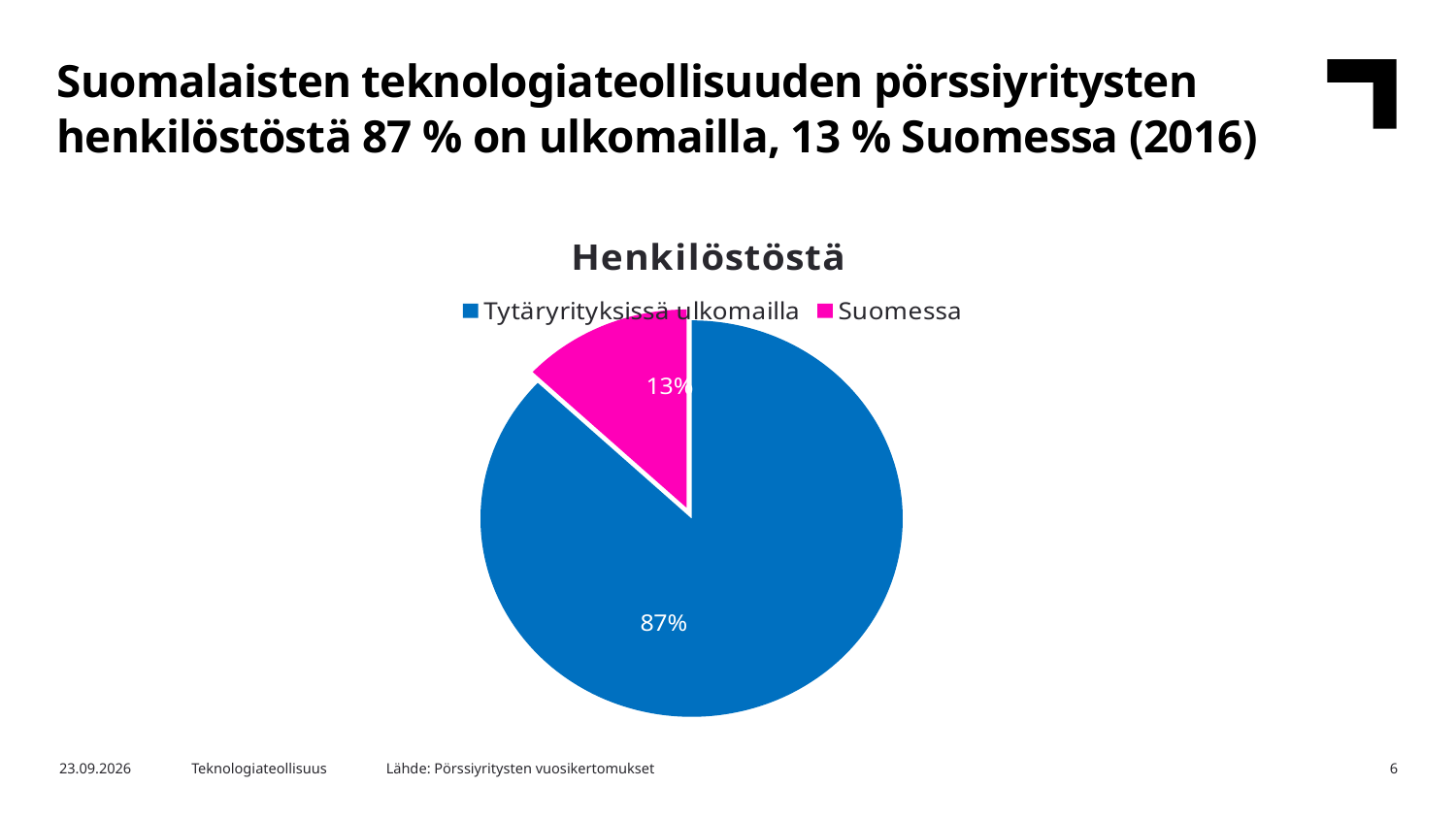
Which is larger, the 'Suomessa' slice or the 'Tytäryrityksissä ulkomailla' slice? Tytäryrityksissä ulkomailla What kind of chart is shown on the slide? Pie chart What share of the pie does the 'Suomessa' slice represent? 13% What is the title of the chart? Henkilöstöstä What share of the pie does the 'Tytäryrityksissä ulkomailla' slice represent? 87% Which slice is the smallest in the pie chart? Suomessa What colour is the 'Suomessa' slice? Magenta (pink) What is the difference in percentage points between the 'Tytäryrityksissä ulkomailla' and 'Suomessa' slices? 74 percentage points Which slice is the largest in the pie chart? Tytäryrityksissä ulkomailla How many slices does the pie chart have? 2 How many entries does the legend list? 2